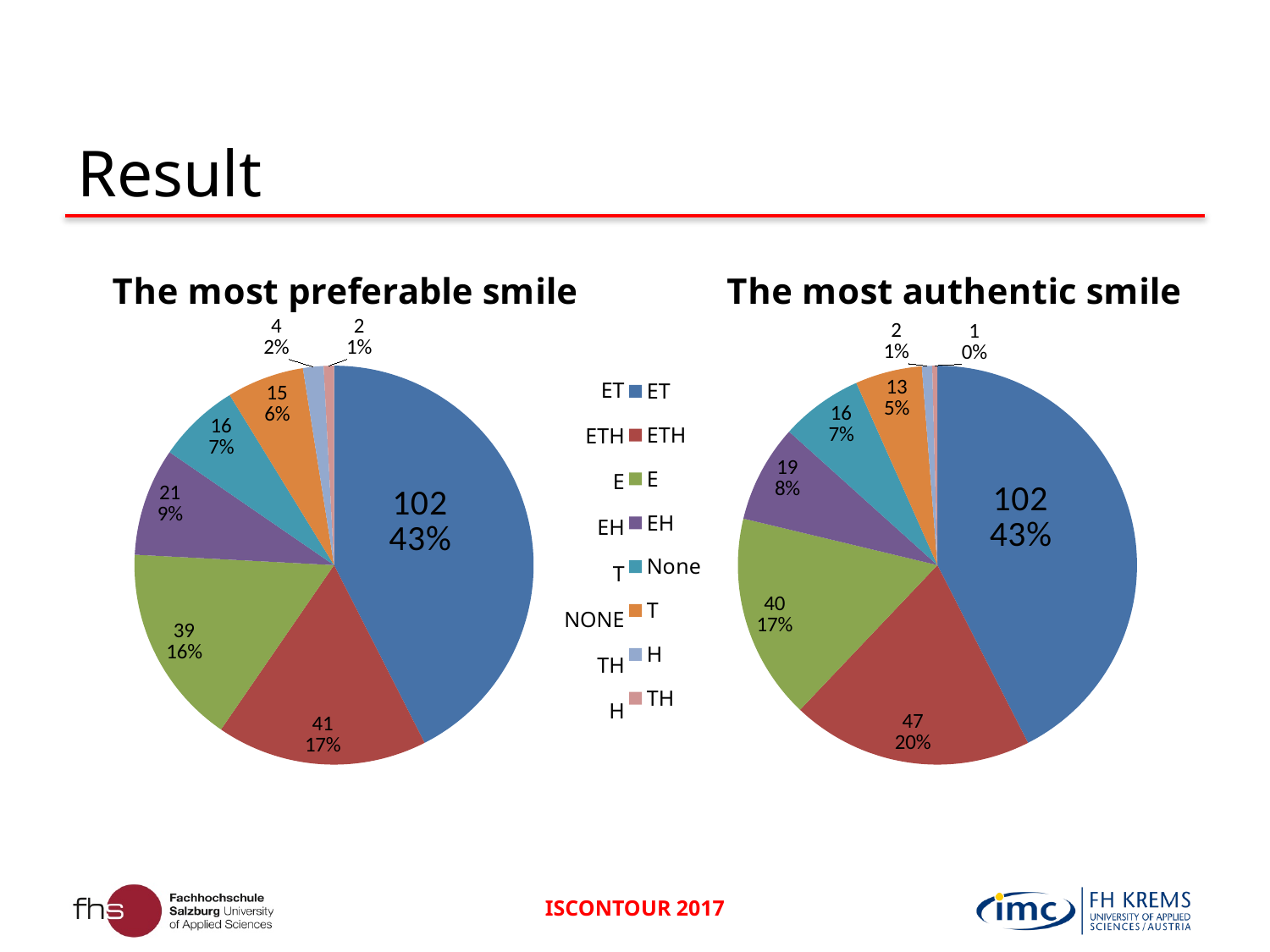
How many slices does "The most preferable smile" pie chart have? 8 In "The most preferable smile" chart, what is the value for EH? 21 What kind of chart is used for "The most preferable smile"? pie chart In "The most authentic smile" chart, what is the difference between the values for ETH and E? 7 In "The most preferable smile" chart, what is the value for ET? 102 In "The most authentic smile" chart, what share of the pie does ETH take? 20% In "The most preferable smile" chart, what share of the pie does ET take? 43% In "The most authentic smile" chart, what is the value for ETH? 47 What is the title of the pie chart on the left of the slide? The most preferable smile In "The most authentic smile" chart, which category has the largest slice? ET In "The most preferable smile" chart, which is larger, the value for ETH or the value for E? ETH What is the difference between the ETH value in "The most authentic smile" chart and the ETH value in "The most preferable smile" chart? 6